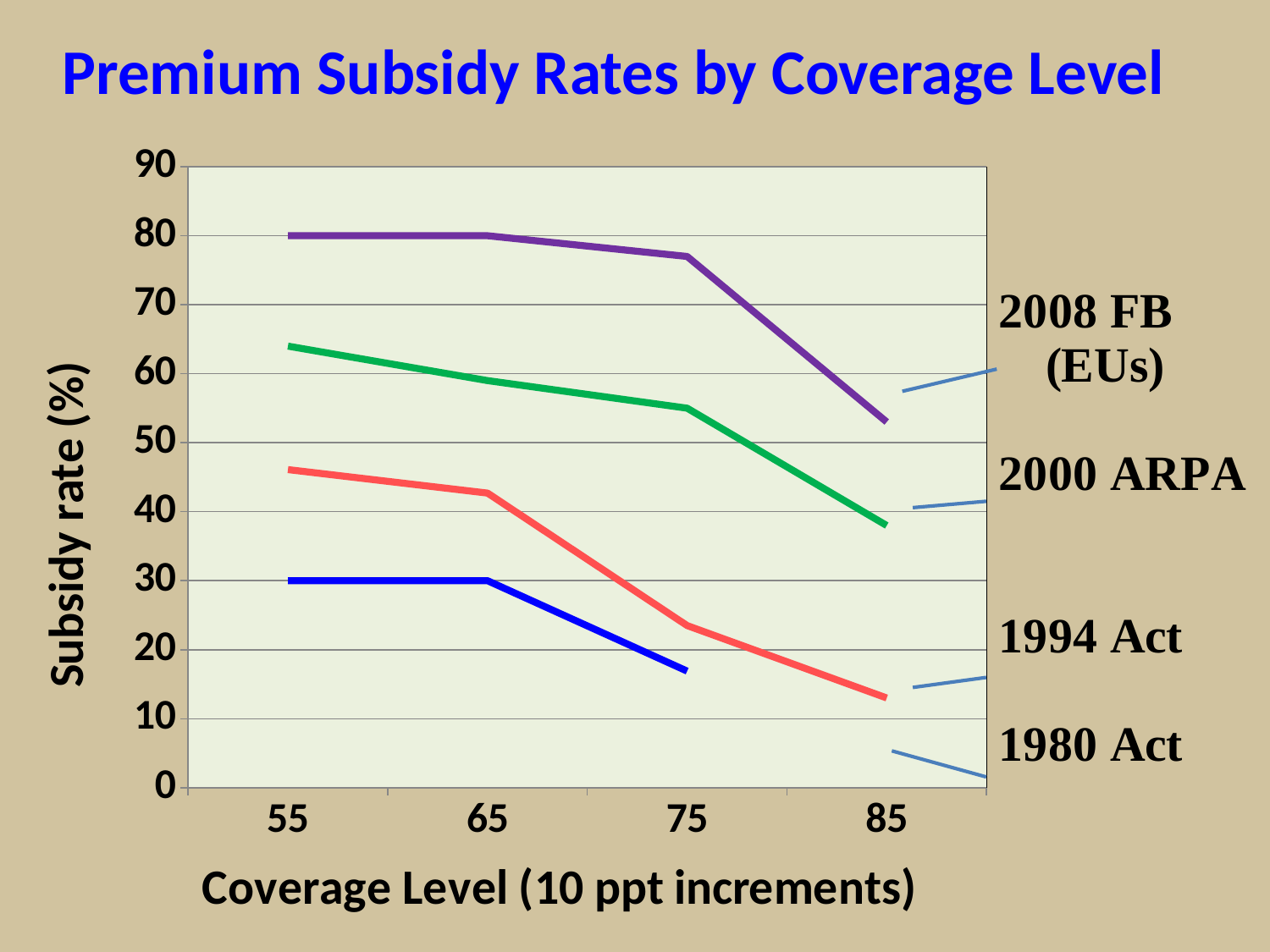
Which series has the highest subsidy rate at the 85 coverage level? 2008 FB (EUs) How many coverage levels are marked on the x axis? 4 Is the subsidy rate for the 1994 Act at the 85 coverage level greater or less than 20? less What kind of chart is shown on the slide? line chart Which series has the lowest subsidy rate at the 55 coverage level? 1980 Act What is the subsidy rate for 2008 FB (EUs) at the 55 coverage level? 80 How many series (lines) are plotted on the chart? 4 Do the subsidy rates rise or fall as the coverage level increases? fall Is the subsidy rate for 2000 ARPA at the 55 coverage level greater or less than 60? greater What is the label on the y axis of the chart? Subsidy rate (%) What is the subsidy rate for the 1980 Act at the 65 coverage level? 30 At the 75 coverage level, which is larger: the subsidy rate for 2000 ARPA or for the 1994 Act? 2000 ARPA